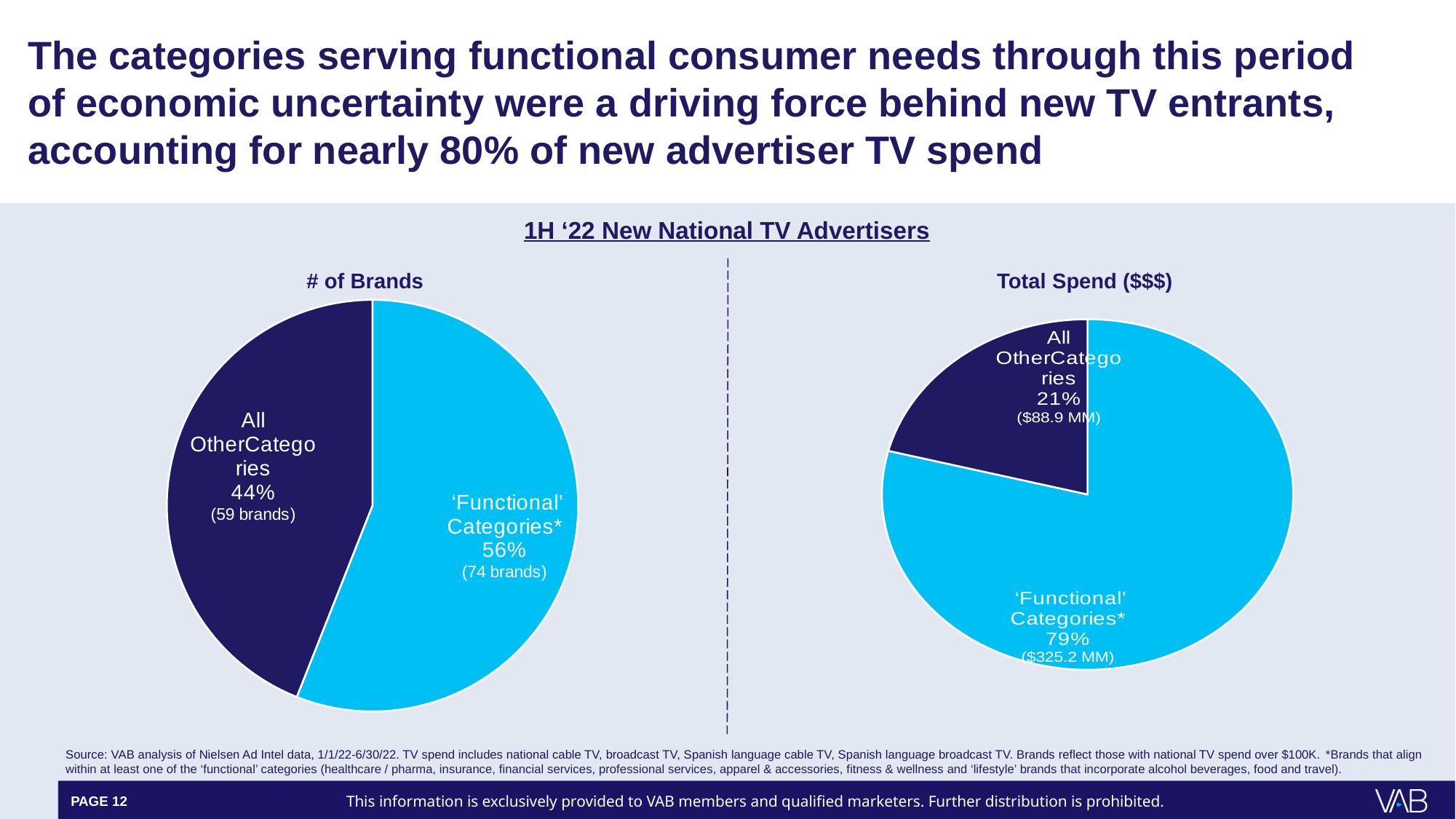
In the 'Total Spend ($$$)' pie chart, what share do 'Functional' Categories account for? 79% In the 'Total Spend ($$$)' pie chart, what is the spend for All Other Categories? $88.9 MM In the '# of Brands' pie chart, how many brands are in 'Functional' Categories? 74 brands How many slices does the 'Total Spend ($$$)' pie chart have? 2 In the '# of Brands' pie chart, which slice is the largest? 'Functional' Categories In the '# of Brands' pie chart, how many more brands are in 'Functional' Categories than in All Other Categories? 15 brands In the 'Total Spend ($$$)' pie chart, what is the spend for 'Functional' Categories? $325.2 MM In the 'Total Spend ($$$)' pie chart, which slice is the smallest? All Other Categories What type of chart is used for '# of Brands'? Pie chart In the 'Total Spend ($$$)' pie chart, what is the difference in percentage points between 'Functional' Categories and All Other Categories? 58 percentage points In the '# of Brands' pie chart, how many brands are in All Other Categories? 59 brands In the '# of Brands' pie chart, what share do 'Functional' Categories account for? 56%